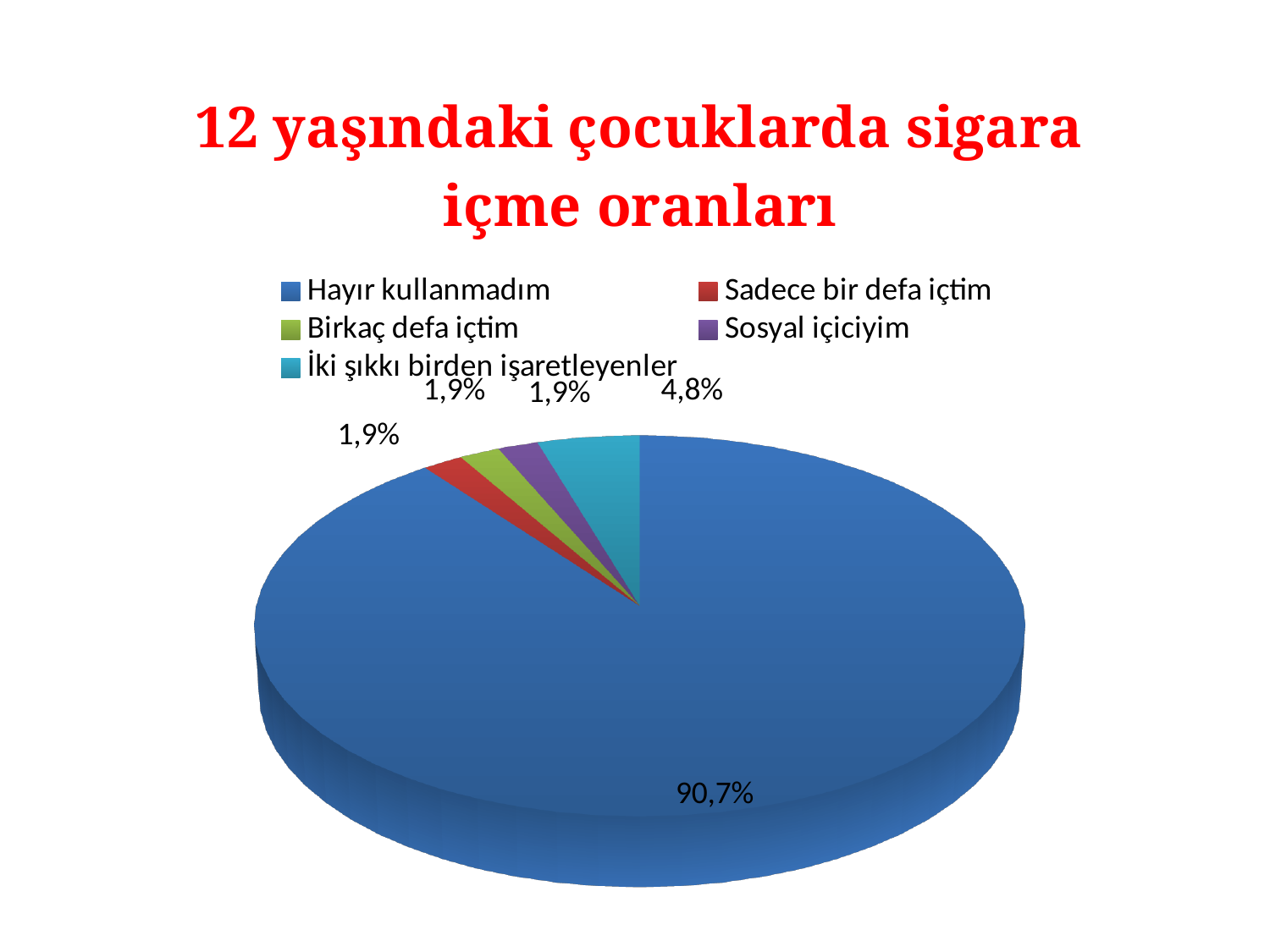
What is the title of the chart on the slide? 12 yaşındaki çocuklarda sigara içme oranları What is the difference in percentage points between "Hayır kullanmadım" and "İki şıkkı birden işaretleyenler"? 85,9% What percentage is shown for "İki şıkkı birden işaretleyenler"? 4,8% Which colour represents "Hayır kullanmadım" in the legend? Blue Which category has the largest slice of the pie? Hayır kullanmadım How many categories does the pie chart show? 5 What percentage is shown for "Sadece bir defa içtim"? 1,9% What percentage of the pie is labelled for "Hayır kullanmadım"? 90,7% What percentage is shown for "Sosyal içiciyim"? 1,9% What is the difference in percentage points between "İki şıkkı birden işaretleyenler" and "Sosyal içiciyim"? 2,9% Which is larger: the slice for "İki şıkkı birden işaretleyenler" or the slice for "Birkaç defa içtim"? İki şıkkı birden işaretleyenler What kind of chart is shown on the slide? Pie chart